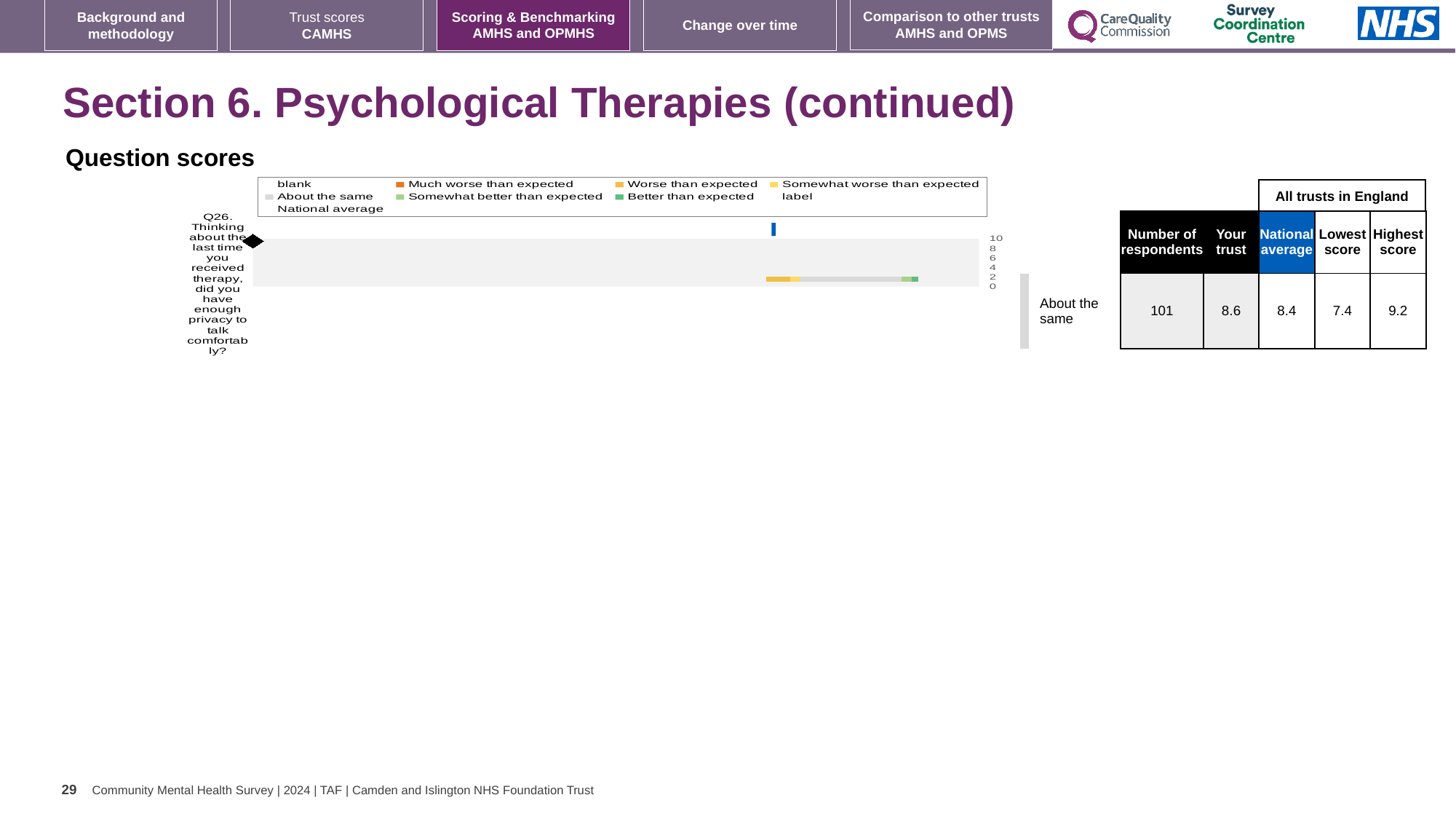
What is the highest value shown on the chart's axis? 10 How many questions (categories) are plotted on the chart? 1 In the table next to the chart, what is the 'Your trust' score for Q26? 8.6 What kind of chart is shown under 'Question scores'? bar chart In the table next to the chart, what is the lowest score among all trusts in England for Q26? 7.4 For Q26, how is the trust's result categorised relative to expectation? About the same In the table next to the chart, what is the national average score for Q26? 8.4 For Q26, which is larger: the 'Your trust' score or the national average? Your trust For Q26, what is the difference between the highest score and the lowest score among all trusts in England? 1.8 In the table next to the chart, how many respondents answered Q26? 101 In the table next to the chart, what is the highest score among all trusts in England for Q26? 9.2 Which question number is plotted on the chart? Q26